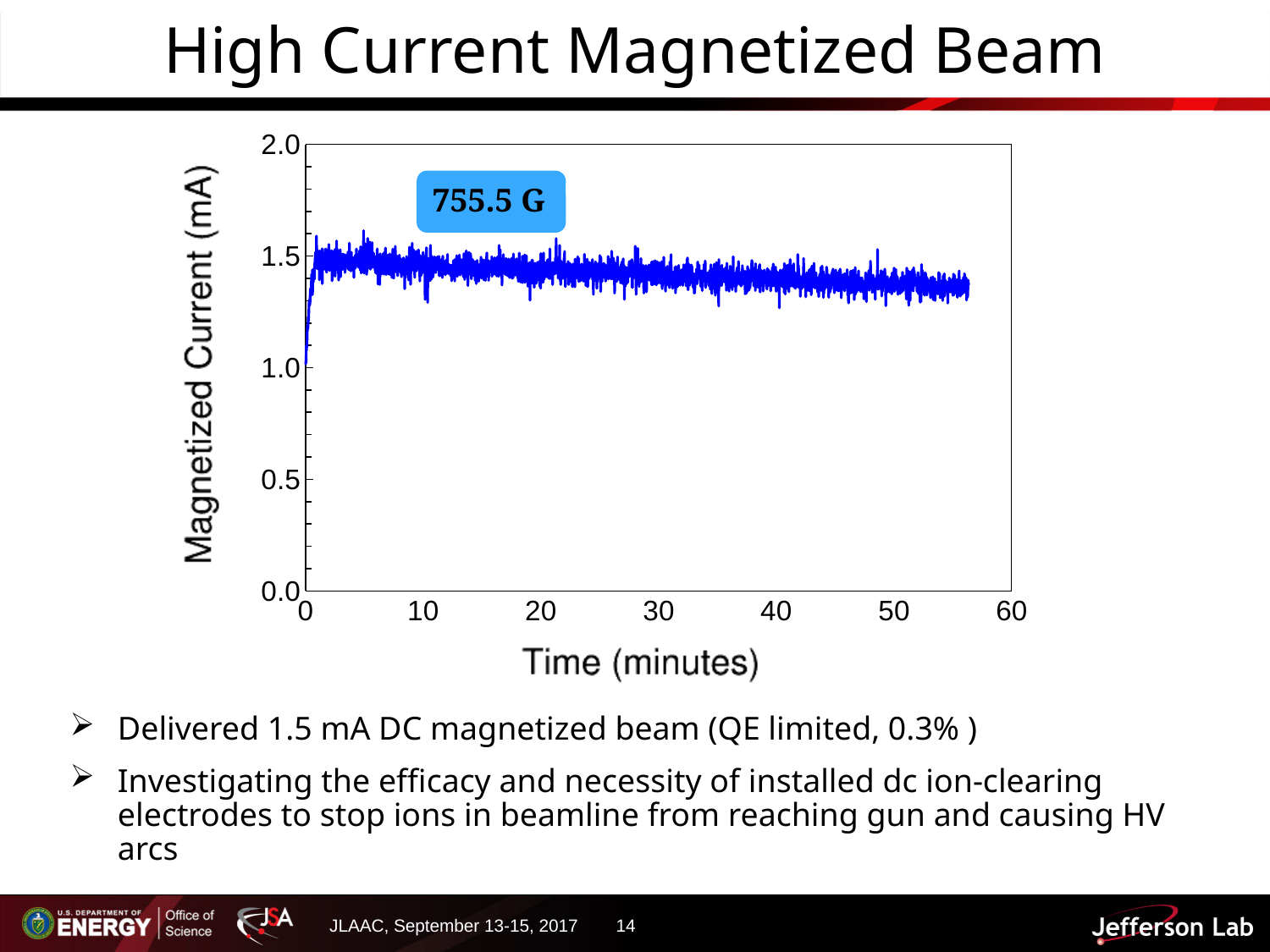
What is the label of the y axis of the chart? Magnetized Current (mA) Is the magnetized current at 30 minutes greater or less than 1.0 mA? greater What is the label of the x axis of the chart? Time (minutes) What is the highest value shown on the y axis of the chart? 2.0 Between 10 and 50 minutes, does the magnetized current rise or fall along the x axis? fall What value is printed in the annotation box on the chart? 755.5 G Is the magnetized current at 50 minutes greater or less than 1.5 mA? less What kind of chart is shown on the slide? line chart How many data series are plotted on the chart? 1 Is the magnetized current at 20 minutes greater or less than 2.0 mA? less Is the magnetized current at 5 minutes greater or less than the current at 55 minutes? greater